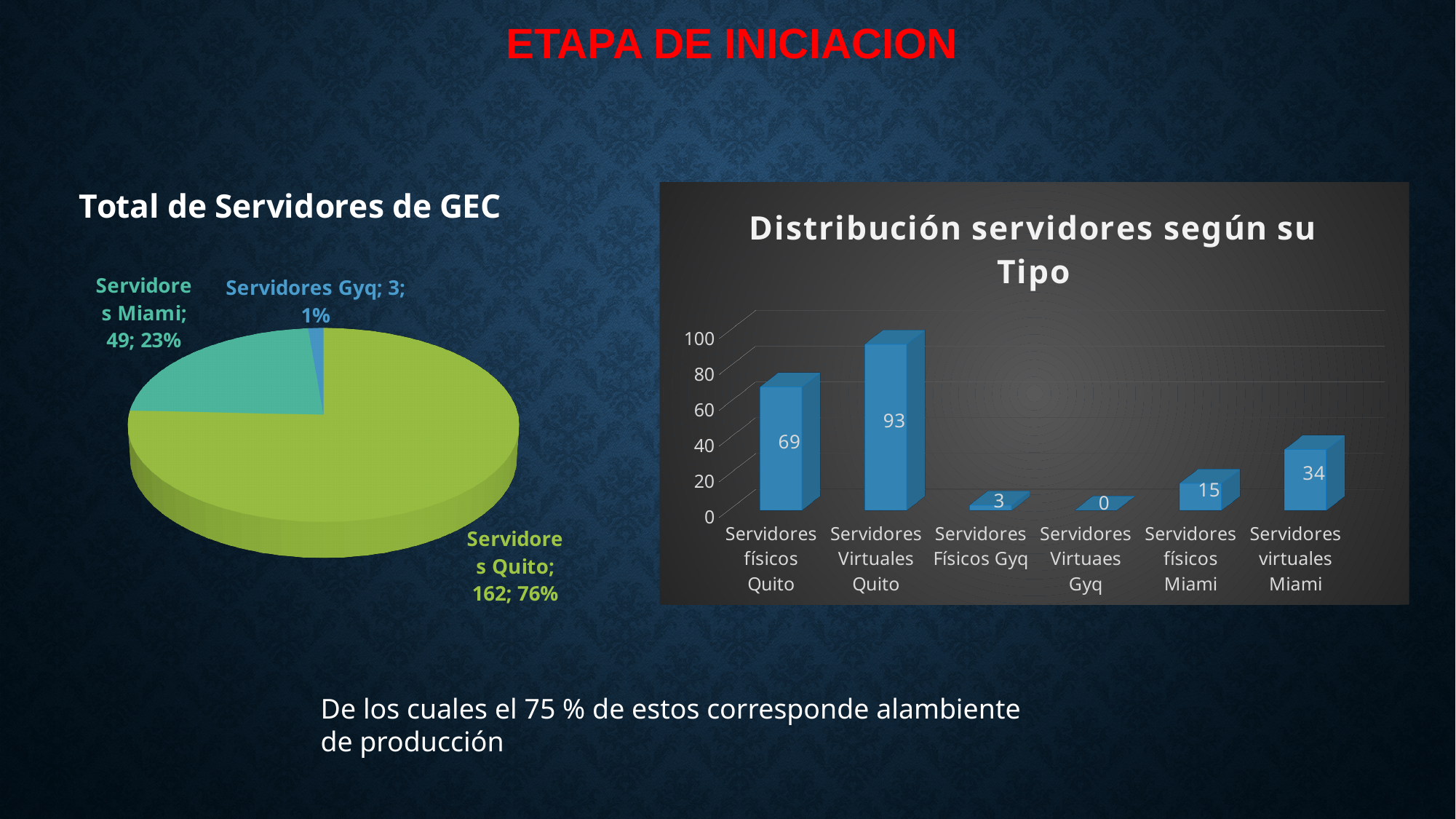
In the 'Distribución servidores según su Tipo' chart, what is the value for Servidores Virtuales Quito? 93 In the 'Total de Servidores de GEC' pie chart, how many servers are in Quito? 162 What kind of chart is 'Distribución servidores según su Tipo'? Bar chart In the 'Distribución servidores según su Tipo' chart, which category has the highest value? Servidores Virtuales Quito In the 'Total de Servidores de GEC' pie chart, how many slices are there? 3 What kind of chart is 'Total de Servidores de GEC'? Pie chart In the 'Total de Servidores de GEC' pie chart, what share of the pie is Servidores Miami? 23% In the 'Total de Servidores de GEC' pie chart, what is the difference between the Quito and Miami server counts? 113 In the 'Distribución servidores según su Tipo' chart, what is the difference between Servidores virtuales Miami and Servidores físicos Miami? 19 In the 'Total de Servidores de GEC' pie chart, which slice is the smallest? Servidores Gyq In the 'Distribución servidores según su Tipo' chart, which category has the lowest value? Servidores Virtuaes Gyq In the 'Distribución servidores según su Tipo' chart, how many categories are shown on the x axis? 6